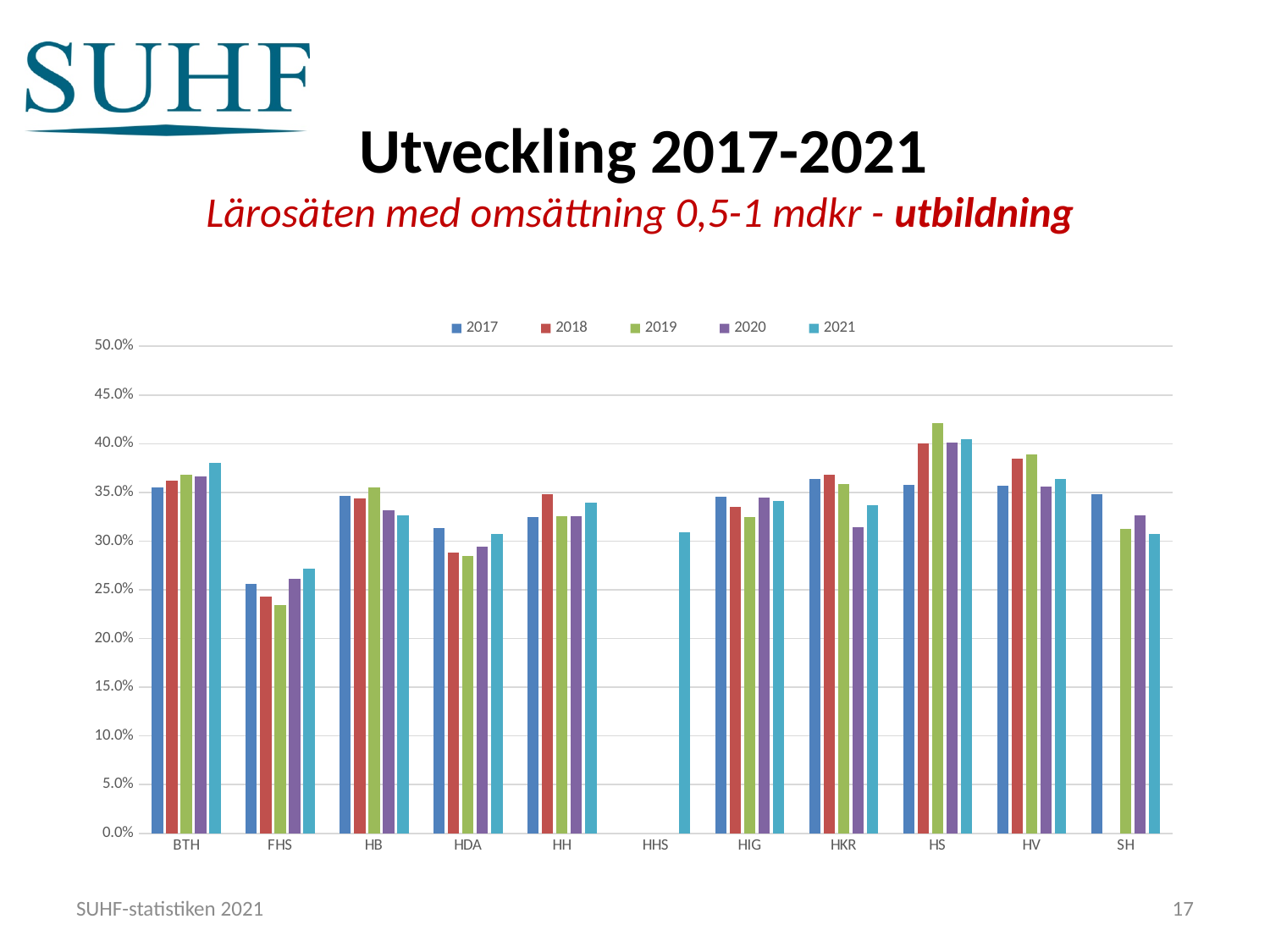
Which is larger, the 2021 value for BTH or the 2021 value for FHS? BTH Which category has a bar for only one year (2021)? HHS Is the value for FHS in 2018 greater or less than 25.0%? less What kind of chart is shown on the slide? bar chart How many series does the legend list? 5 Which category and year has the lowest bar in the chart? FHS, 2019 Which is larger, the 2018 value for HDA or the 2018 value for HH? HH Is the value for HDA in 2019 greater or less than 30.0%? less How many categories (lärosäten) are shown on the x axis? 11 Is the value for HKR in 2020 greater or less than 35.0%? less Which category and year has the highest bar in the chart? HS, 2019